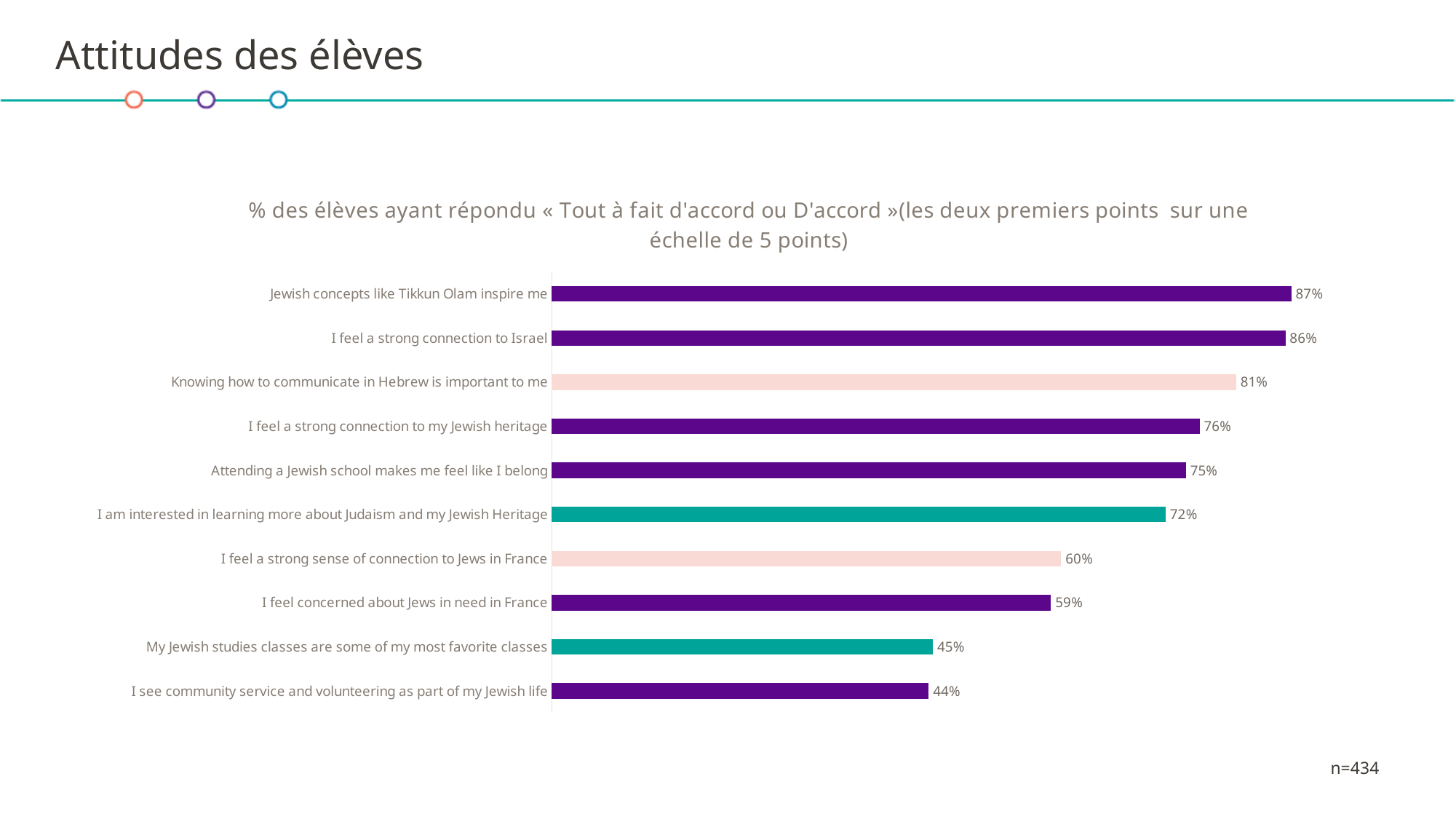
What percentage is shown for "My Jewish studies classes are some of my most favorite classes"? 45% What colour is the bar for "I am interested in learning more about Judaism and my Jewish Heritage"? Teal What type of chart is shown on the slide? Bar chart How many statements are plotted in the chart? 10 What is the value shown for "Knowing how to communicate in Hebrew is important to me"? 81% What sample size (n) is shown on the slide? n=434 Which has a higher value: "I feel a strong connection to my Jewish heritage" or "I am interested in learning more about Judaism and my Jewish Heritage"? I feel a strong connection to my Jewish heritage Which statement has the highest percentage of agreement? Jewish concepts like Tikkun Olam inspire me What percentage of students agreed with "I feel a strong connection to Israel"? 86% What is the difference between the values for "Jewish concepts like Tikkun Olam inspire me" and "I feel a strong sense of connection to Jews in France"? 27% What is the difference between the values for "I feel concerned about Jews in need in France" and "I see community service and volunteering as part of my Jewish life"? 15% Which statement has the lowest percentage of agreement? I see community service and volunteering as part of my Jewish life